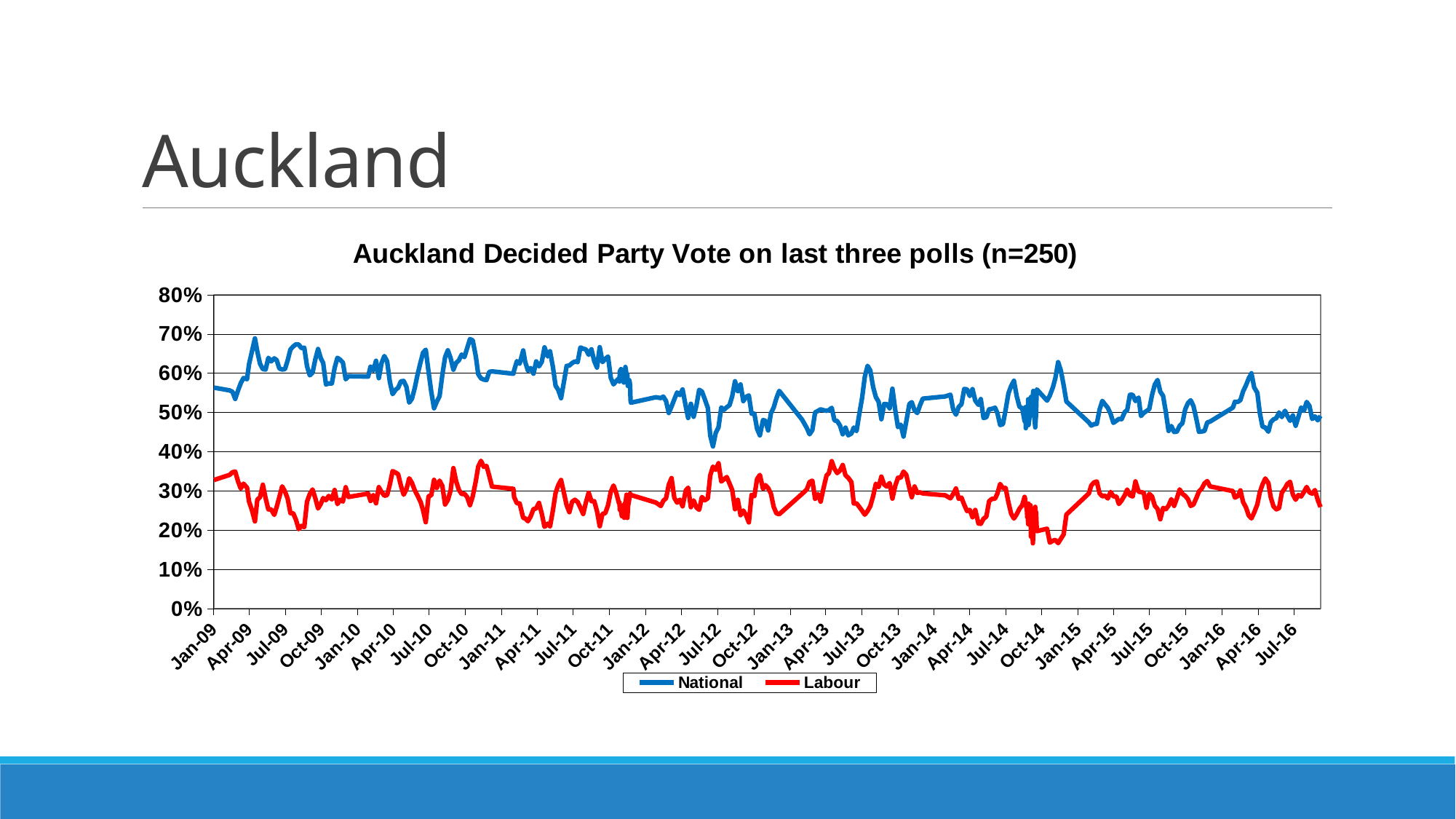
How many date labels are shown on the x axis? 31 Which colour is used for the Labour series? red What kind of chart is shown on the slide? line chart What is the title of the chart? Auckland Decided Party Vote on last three polls (n=250) Is the value for National at Jul-16 greater or less than 40%? greater Is the value for National at Jan-09 greater or less than 50%? greater How many series does the legend list? 2 Which series has the higher values throughout the chart, National or Labour? National Is the lowest value for Labour around Oct-14 greater or less than 20%? less Overall, does the National series rise or fall from Jan-09 to Jul-16? fall